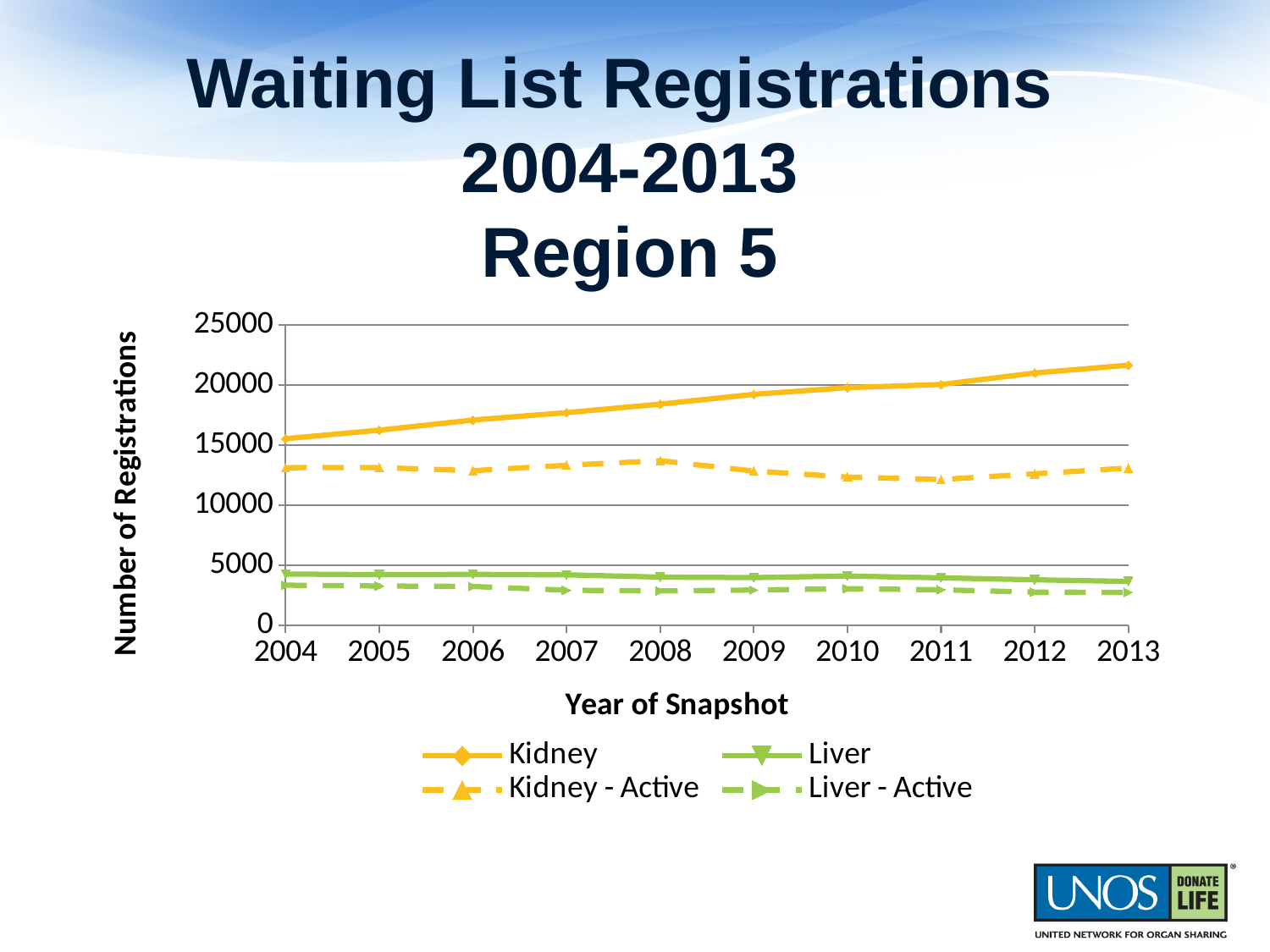
What kind of chart is shown on the slide? Line chart In which year is the Kidney - Active series highest? 2008 Is the Kidney value for 2013 greater or less than 20000? greater Is the Kidney - Active value for 2008 greater or less than 15000? less How many series does the legend list? 4 Does the Liver line generally rise or fall from 2004 to 2013? Fall Does the Kidney line rise or fall from 2004 to 2013? Rise How many years are plotted along the x axis? 10 In which year is the Kidney series lowest? 2004 Which is larger in 2013, the Kidney value or the Liver value? Kidney In which year is the Kidney series highest? 2013 What is the title of the y axis? Number of Registrations